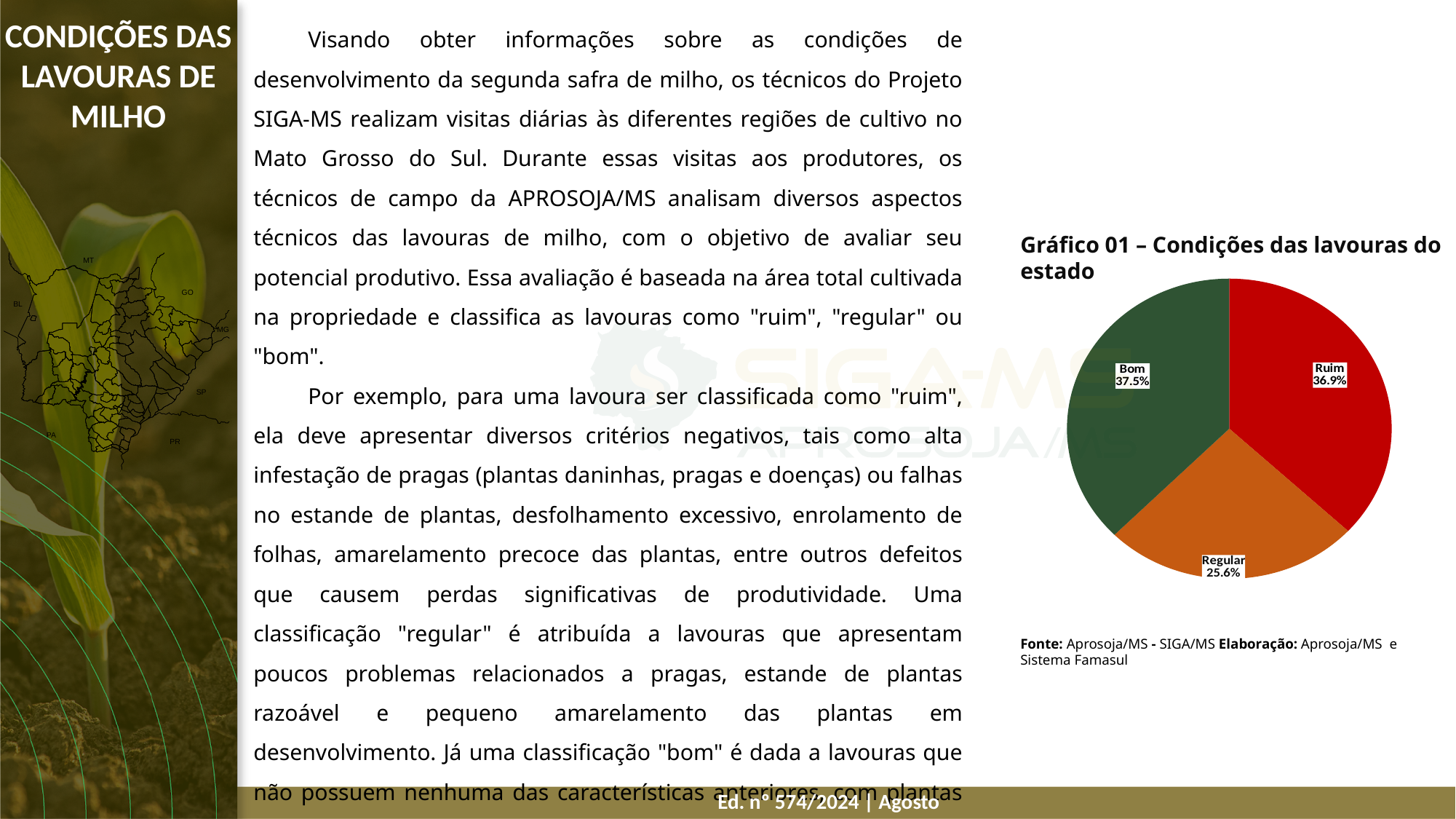
What is the title of the chart? Gráfico 01 – Condições das lavouras do estado What percentage of the pie is labelled "Bom"? 37.5% What colour is the "Ruim" slice of the pie? Red Which category has the largest share of the pie? Bom What is the difference in percentage points between the "Bom" and "Regular" slices? 11.9 Which slice is larger, "Ruim" or "Regular"? Ruim What percentage of the pie is labelled "Regular"? 25.6% What percentage of the pie is labelled "Ruim"? 36.9% What type of chart is shown on the slide? Pie chart Which category has the smallest share of the pie? Regular What is the difference in percentage points between the "Ruim" and "Regular" slices? 11.3 How many slices does the pie chart have? 3